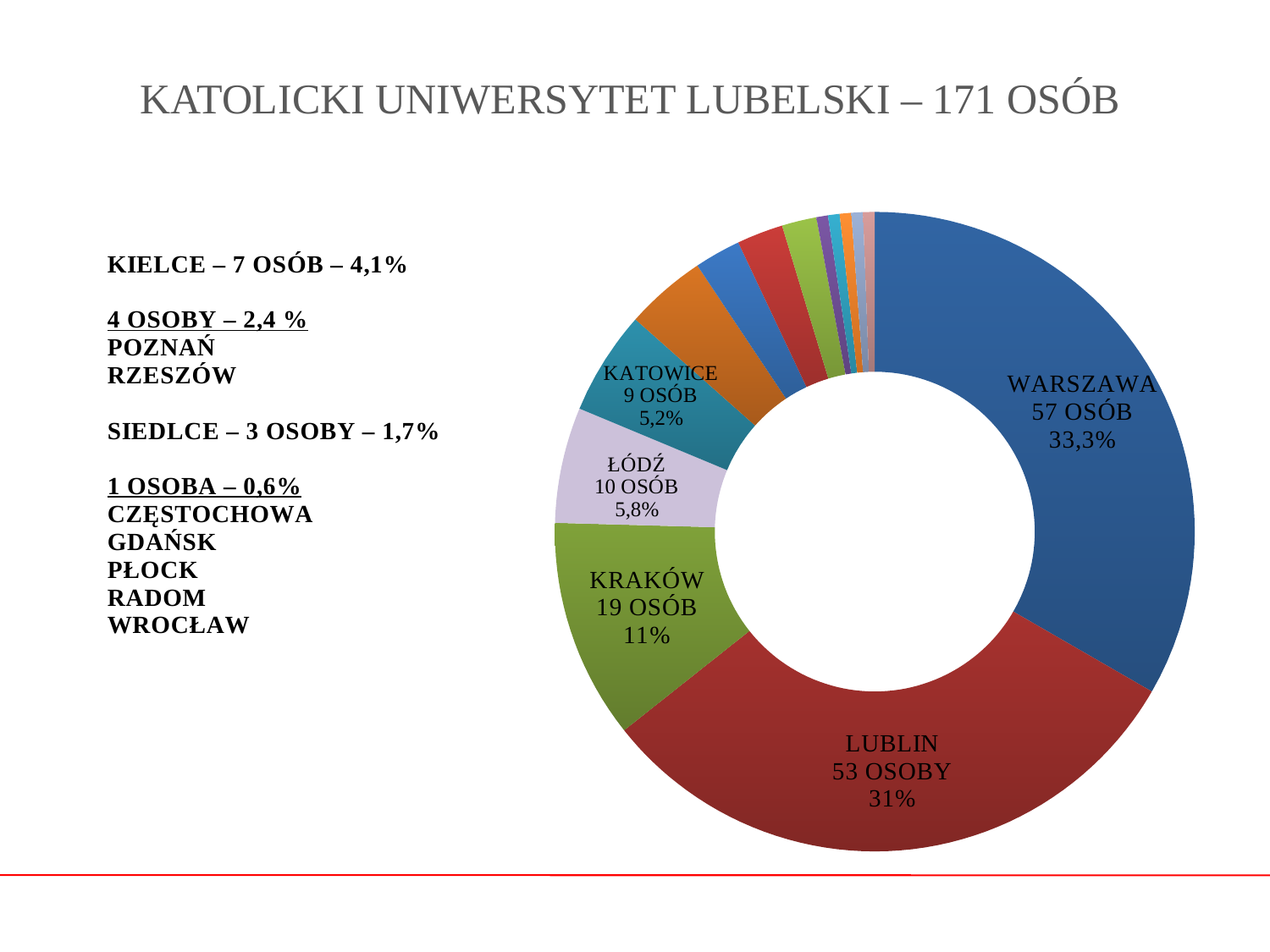
How many people does the Kraków slice represent? 19 osób How many people does the Katowice slice represent? 9 osób What percentage share does the Lublin slice have? 31% What is the percentage share of the Warszawa slice? 33,3% How many people does the Warszawa slice represent? 57 osób Which city has the largest slice of the chart? Warszawa What is the total number of people represented by the chart, according to the title? 171 osób What is the title of the slide containing the chart? KATOLICKI UNIWERSYTET LUBELSKI – 171 OSÓB What kind of chart is shown on the slide? Doughnut (pie) chart Which slice is larger, Kraków or Łódź? Kraków What percentage share does the Łódź slice have? 5,8% What is the difference in number of people between Warszawa and Lublin? 4